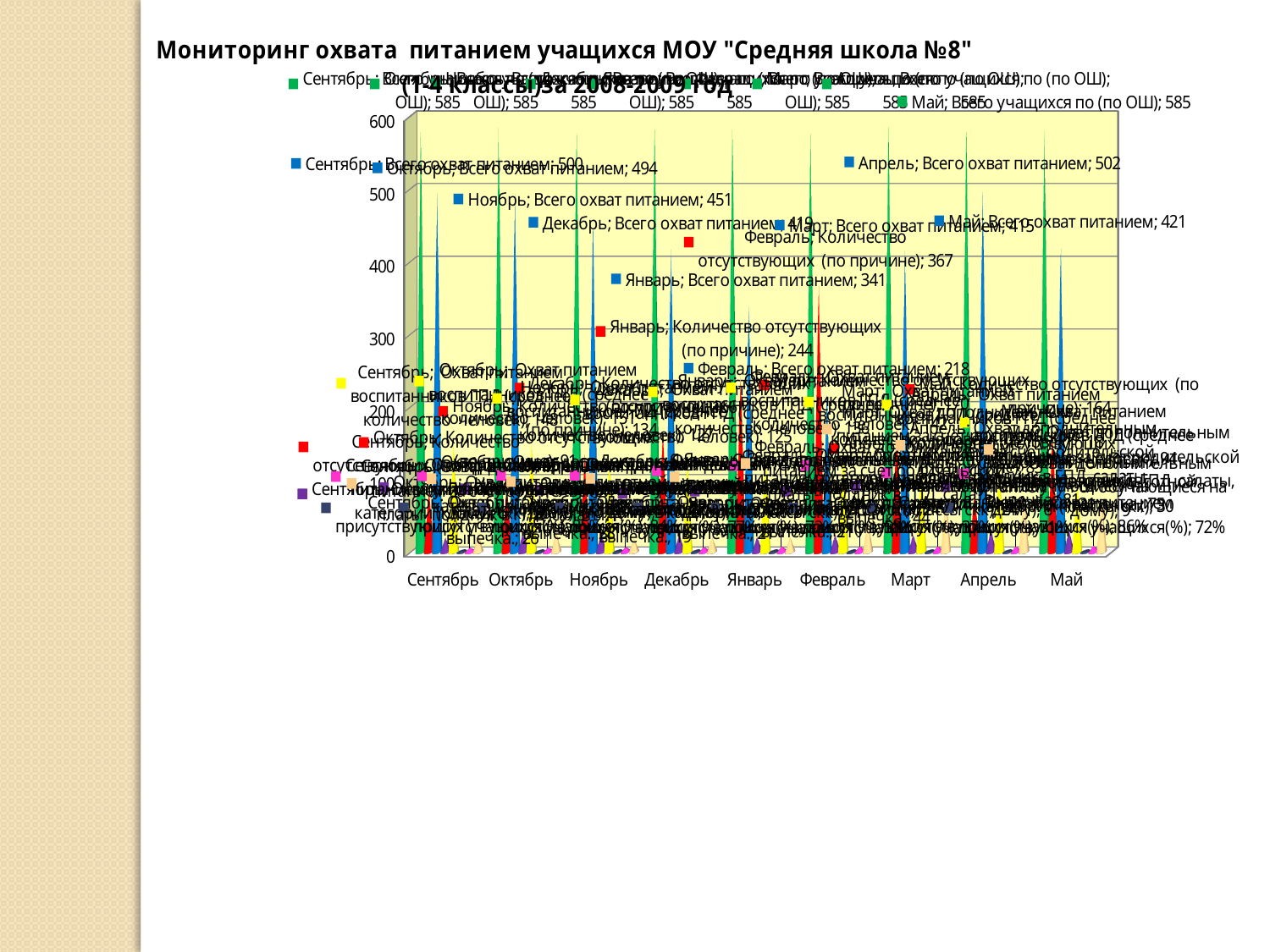
What is the value of "Количество отсутствующих (по причине)" for Февраль? 367 What kind of chart is shown on the slide? Bar chart How many months are shown on the x axis? 9 Which is larger, "Всего охват питанием" for Ноябрь or for Март? Ноябрь What is the difference between "Всего охват питанием" for Апрель and for Май? 81 What is the value of "Всего охват питанием" for Октябрь? 494 What is the difference between "Всего охват питанием" for Сентябрь and for Февраль? 282 What is the value of "Всего учащихся по (по ОШ)" for Май? 585 What is the value of "Всего охват питанием" for Февраль? 218 Which month has the lowest value of "Всего охват питанием"? Февраль Which month has the highest value of "Всего охват питанием"? Апрель What is the value of "Всего охват питанием" for Сентябрь? 500